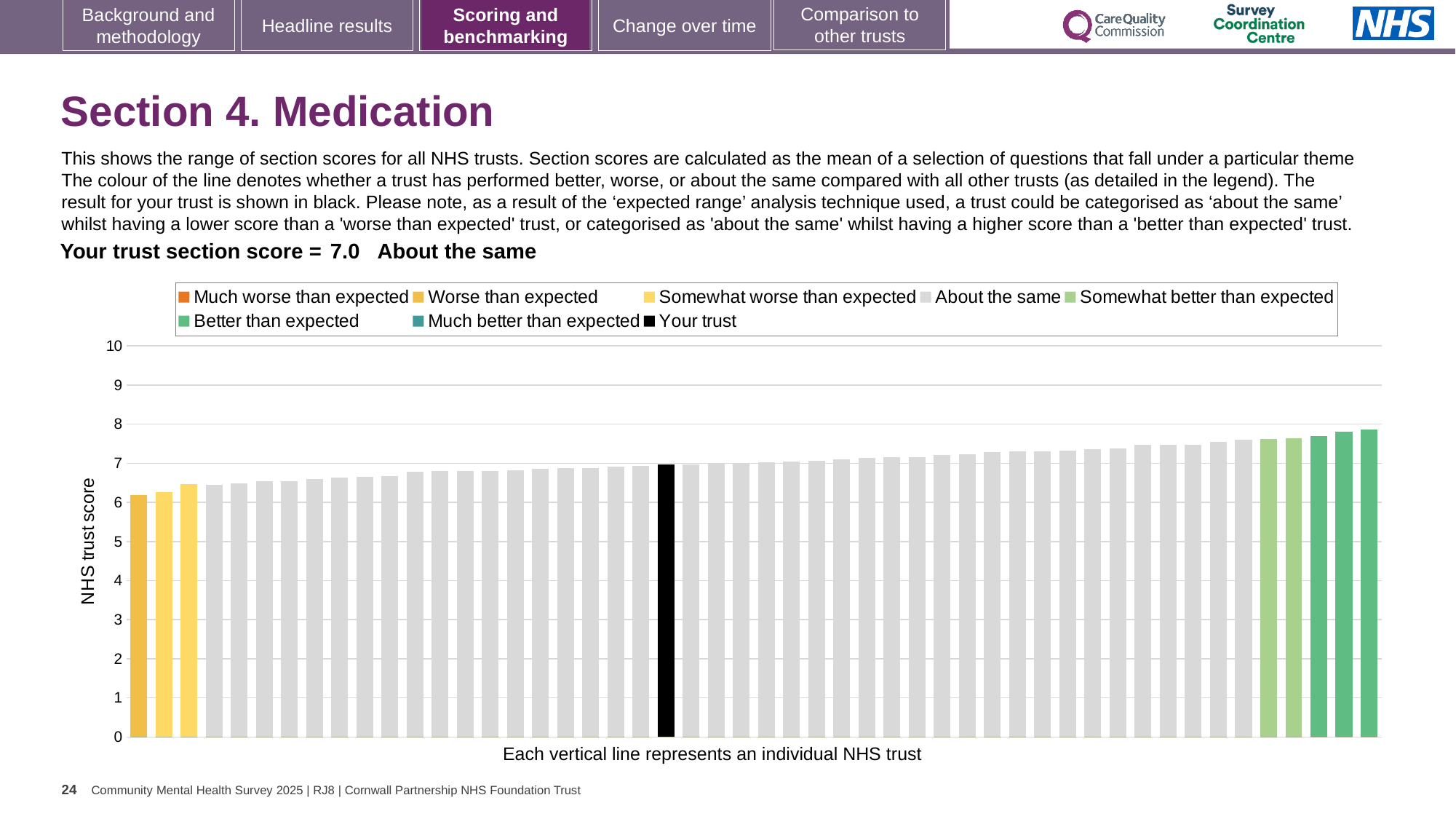
Do the bar values rise or fall from left to right along the x axis? rise Which category does your trust's section score fall into according to the slide? About the same Is the value of the tallest bar greater or less than 7? greater How many entries does the chart legend list? 8 What is the section score for your trust shown on the slide? 7.0 What kind of chart is shown on the slide? bar chart Is the value of the leftmost bar greater or less than 7? less Is the value of the leftmost bar greater or less than 5? greater What colour is the bar representing your trust? black What is the label on the vertical axis of the chart? NHS trust score Is the rightmost bar taller or shorter than the black bar? taller